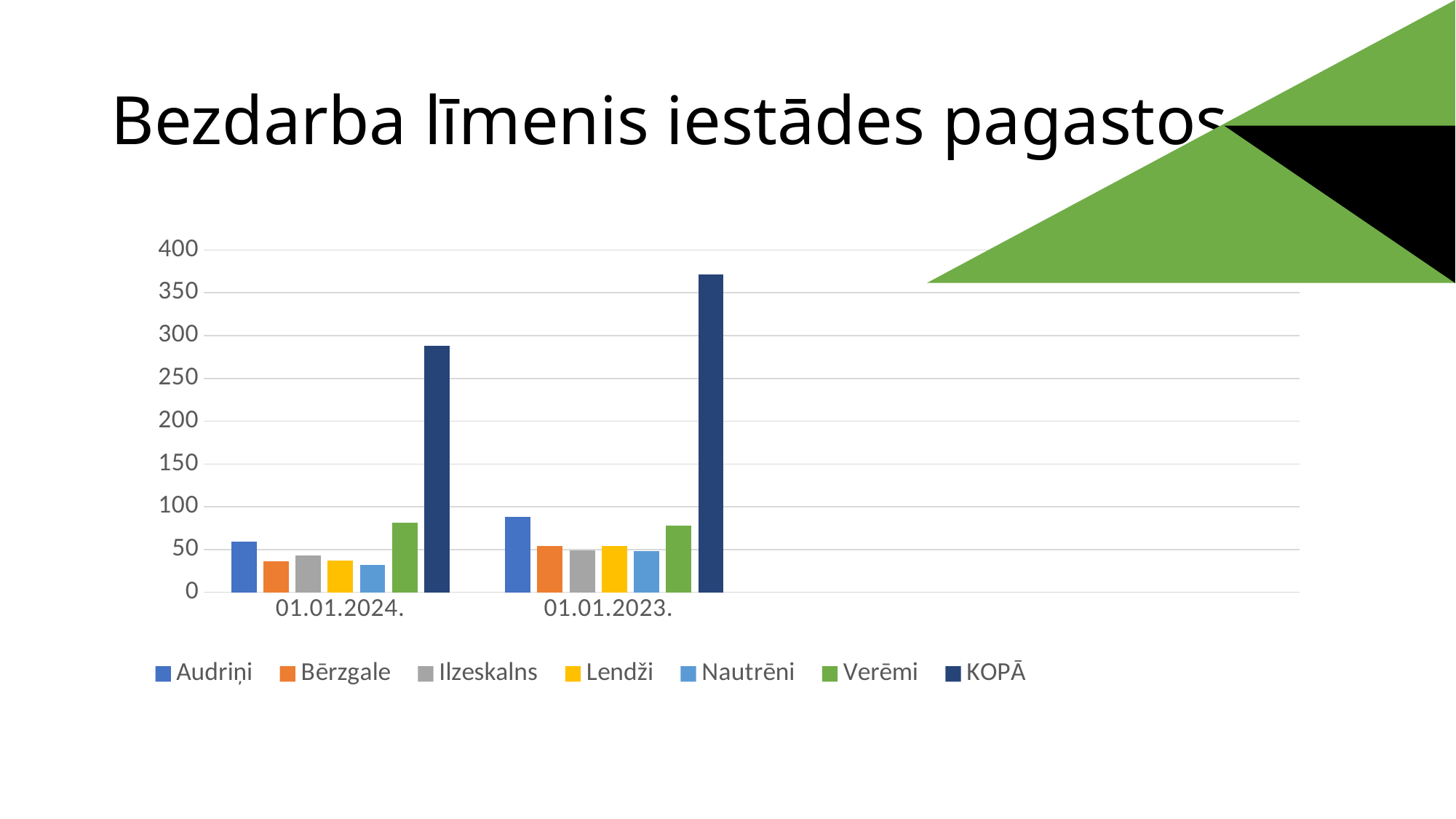
Is the Audriņi value for 01.01.2023. greater or less than 100? less Which is larger for 01.01.2024., Audriņi or Verēmi? Verēmi Which is larger, the KOPĀ value for 01.01.2024. or for 01.01.2023.? 01.01.2023. How many categories are shown on the x axis? 2 How many series does the legend list? 7 What kind of chart is shown on the slide? bar chart Is the KOPĀ value for 01.01.2023. greater or less than 350? greater What is the title of the slide? Bezdarba līmenis iestādes pagastos Which series has the highest value for 01.01.2024.? KOPĀ Which series has the highest value for 01.01.2023.? KOPĀ Is the KOPĀ value for 01.01.2024. greater or less than 300? less